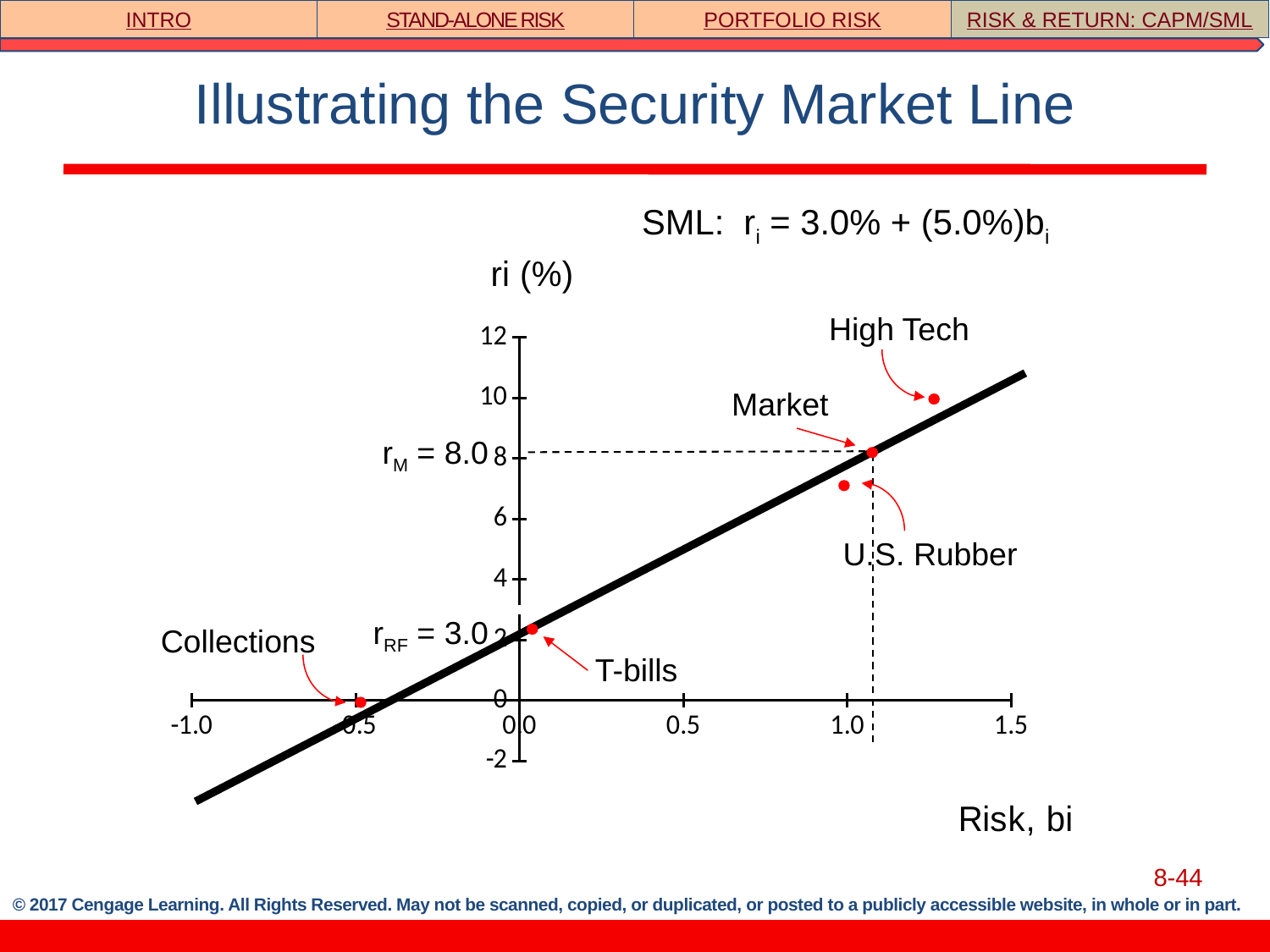
Which has the higher return, High Tech or Market? High Tech What is the difference between the Market return r_M and the risk-free rate r_RF? 5.0 How many labeled securities are plotted on the chart? 5 Is the beta (risk) for High Tech greater or less than 1.0? greater What is the risk-free rate r_RF shown for T-bills on the chart? 3.0 What is the required return r_M for the Market point on the chart? 8.0 Does the Security Market Line rise or fall as risk (beta) increases along the x axis? rises Is the beta (risk) for Collections greater or less than 0.0? less Which labeled security has the lowest return on the chart? Collections Is the return for U.S. Rubber greater or less than 8? less What is the label of the x axis on the chart? Risk, bi Which labeled security has the highest return on the chart? High Tech